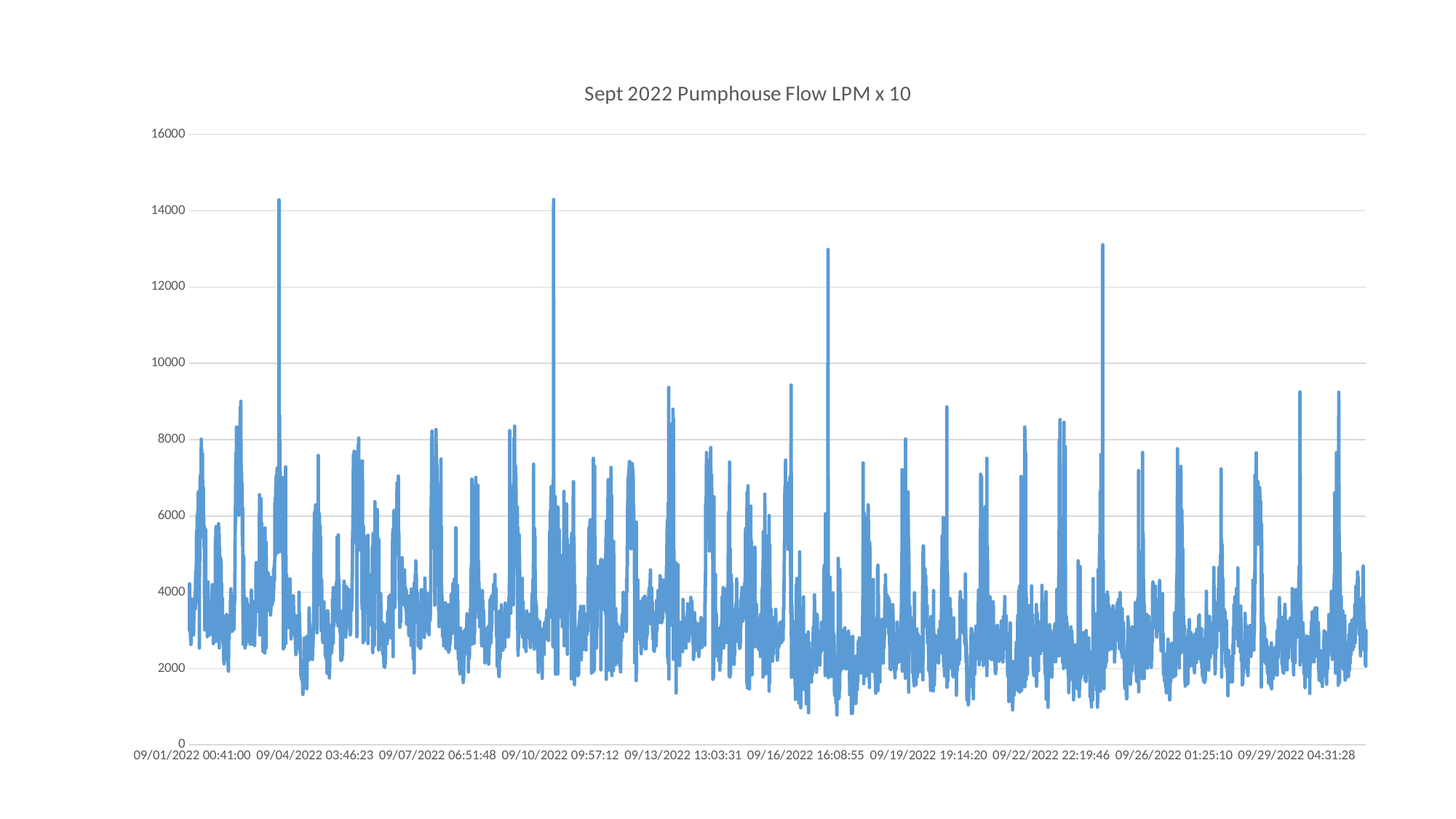
Is the peak near 09/16/2022 16:08:55 greater or less than 12000? greater What is the first date label on the horizontal axis? 09/01/2022 00:41:00 How many date labels are shown along the horizontal axis? 10 What is the highest value shown on the vertical axis? 16000 Is the lowest value on the chart greater or less than 2000? less What kind of chart is shown on the slide? Line chart Is the highest peak on the chart greater or less than 14000? greater What is the title of the chart? Sept 2022 Pumphouse Flow LPM x 10 What is the last date label on the horizontal axis? 09/29/2022 04:31:28 What is the interval between gridlines on the vertical axis? 2000